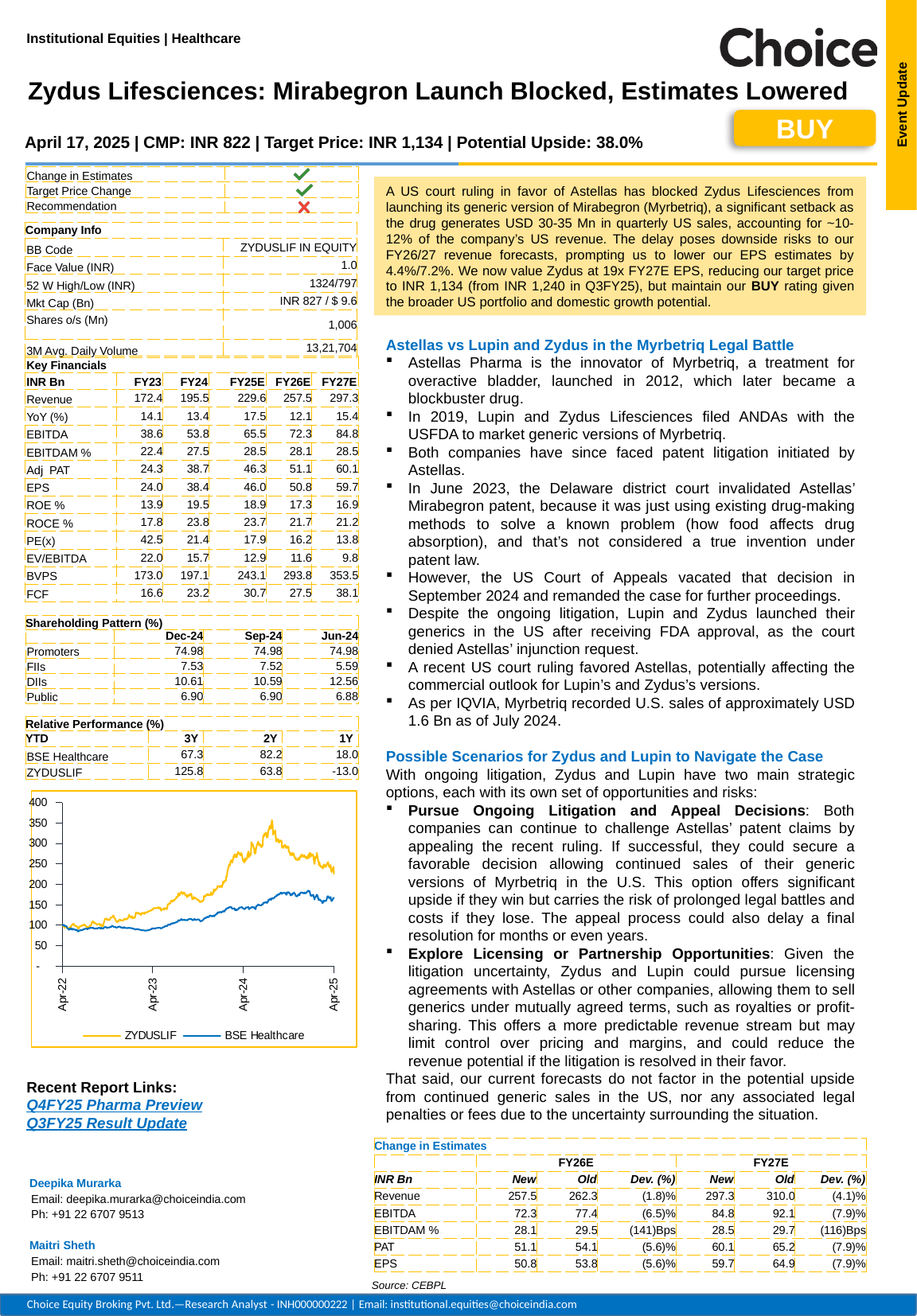
Which series reaches the highest value anywhere on the chart? ZYDUSLIF Does the ZYDUSLIF line overall rise or fall from Apr-22 to Apr-25? rise At Apr-25, is the BSE Healthcare line greater or less than 200? less At Apr-25, which series is higher, ZYDUSLIF or BSE Healthcare? ZYDUSLIF What kind of chart is shown on the slide? line chart Is the peak value of the BSE Healthcare line greater or less than 200? less How many date labels are shown on the chart's x axis? 4 At Apr-25, is the ZYDUSLIF line greater or less than 200? greater How many series does the chart's legend list? 2 What are the two series named in the chart's legend? ZYDUSLIF and BSE Healthcare Which colour is used for the ZYDUSLIF line in the chart? yellow